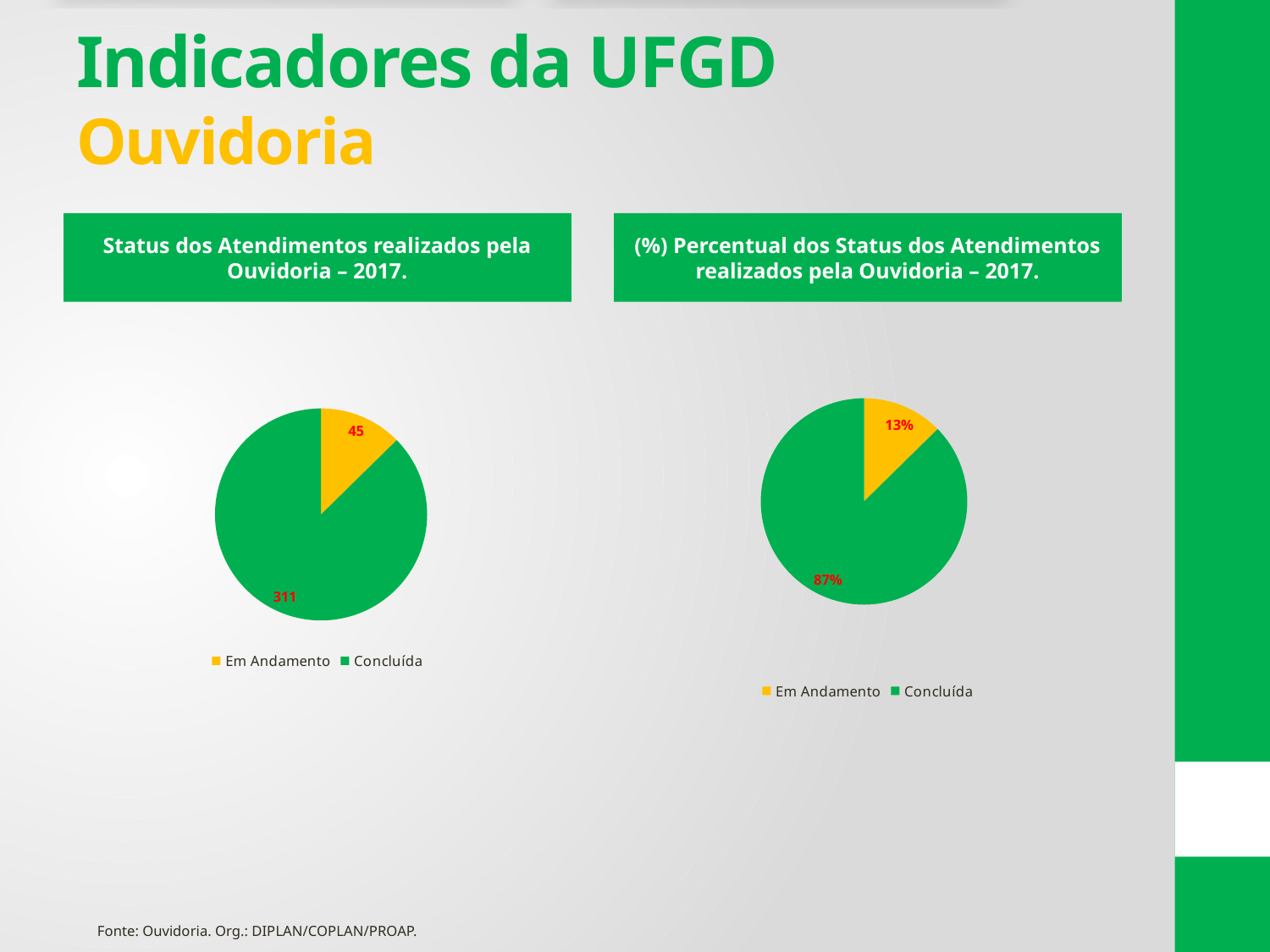
How many categories does the legend of the right chart ((%) Percentual dos Status dos Atendimentos realizados pela Ouvidoria – 2017) list? 2 In the left chart (Status dos Atendimentos realizados pela Ouvidoria – 2017), what is the difference between Concluída and Em Andamento? 266 In the left chart (Status dos Atendimentos realizados pela Ouvidoria – 2017), what is the value for Concluída? 311 In the right chart ((%) Percentual dos Status dos Atendimentos realizados pela Ouvidoria – 2017), which category has the smallest slice? Em Andamento What kind of chart is the left chart (Status dos Atendimentos realizados pela Ouvidoria – 2017)? Pie chart In the left chart (Status dos Atendimentos realizados pela Ouvidoria – 2017), which category has the largest slice? Concluída In the right chart ((%) Percentual dos Status dos Atendimentos realizados pela Ouvidoria – 2017), what is the percentage for Concluída? 87% In the right chart ((%) Percentual dos Status dos Atendimentos realizados pela Ouvidoria – 2017), what colour is the Em Andamento slice? Yellow In the right chart ((%) Percentual dos Status dos Atendimentos realizados pela Ouvidoria – 2017), what is the percentage for Em Andamento? 13% In the left chart (Status dos Atendimentos realizados pela Ouvidoria – 2017), what is the total of the two slices? 356 In the left chart (Status dos Atendimentos realizados pela Ouvidoria – 2017), what is the value for Em Andamento? 45 In the left chart (Status dos Atendimentos realizados pela Ouvidoria – 2017), which is larger, Em Andamento or Concluída? Concluída